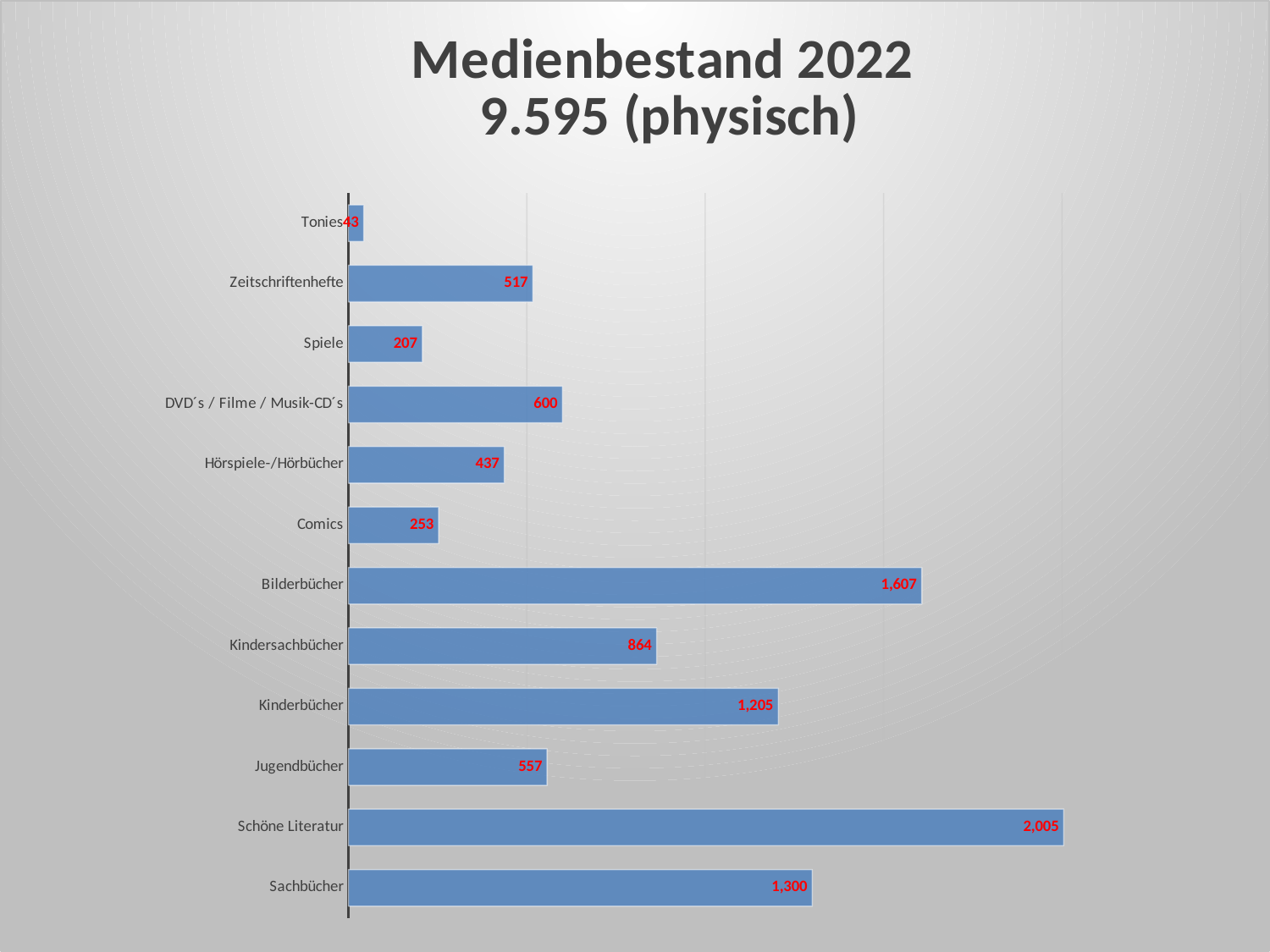
How many categories are shown in the chart? 12 What is the value for Bilderbücher? 1,607 What is the value for Hörspiele-/Hörbücher? 437 Which is larger, Zeitschriftenhefte or Jugendbücher? Jugendbücher Which category has the highest value? Schöne Literatur What is the difference between DVD´s / Filme / Musik-CD´s and Spiele? 393 What is the value for Schöne Literatur? 2,005 Which category has the lowest value? Tonies What kind of chart is shown on the slide? Bar chart What is the title of the chart? Medienbestand 2022 9.595 (physisch) What is the value for Tonies? 43 What is the difference between Sachbücher and Kinderbücher? 95